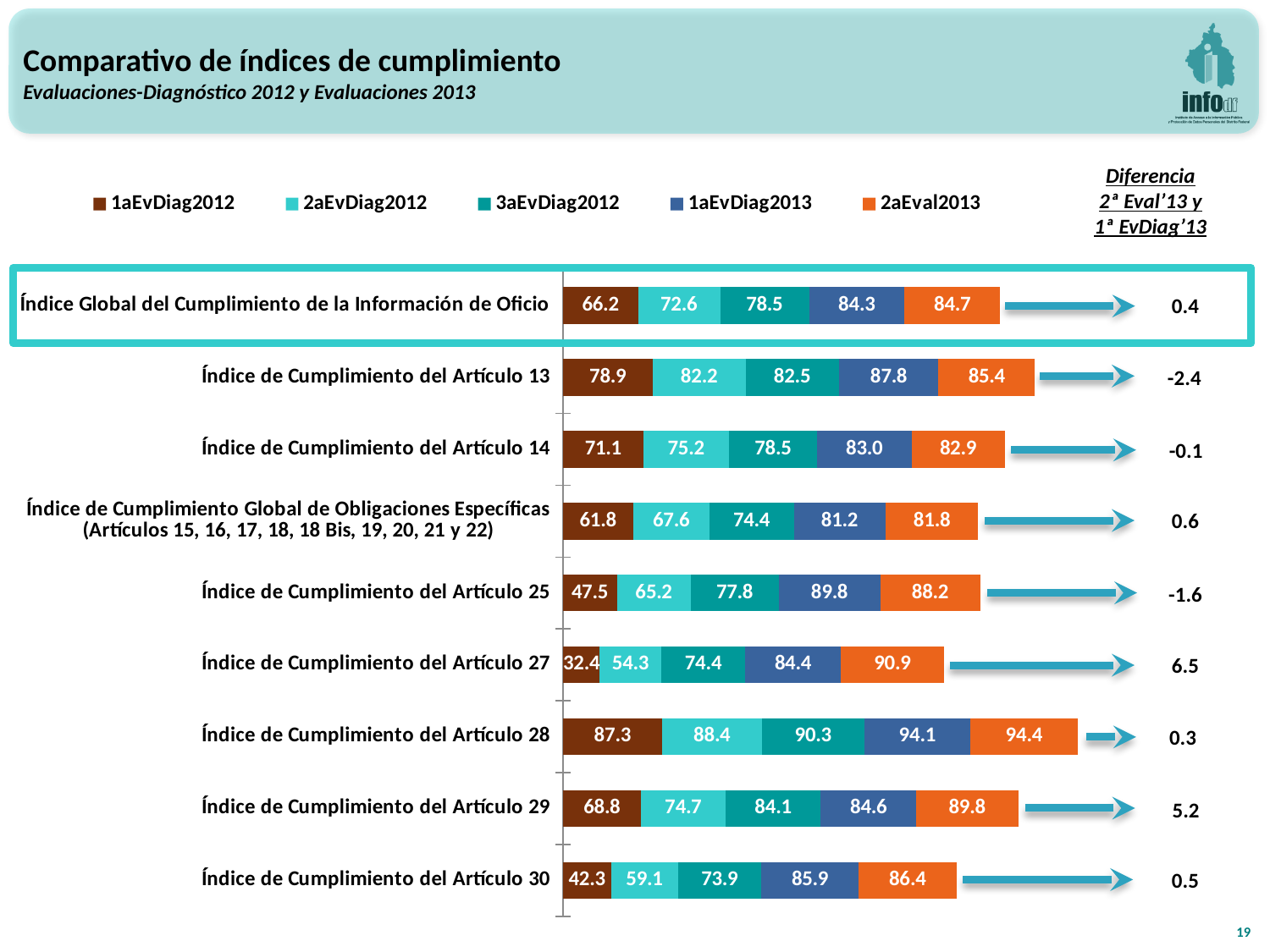
Which category has the highest 2aEval2013 value? Índice de Cumplimiento del Artículo 28 How many series does the legend list? 5 For Índice de Cumplimiento del Artículo 25, which is larger: the 1aEvDiag2013 value or the 2aEval2013 value? 1aEvDiag2013 How many categories (índices) are shown in the chart? 9 What is the difference between the 2aEval2013 and 1aEvDiag2013 values for Índice de Cumplimiento del Artículo 29? 5.2 Which category has the lowest 1aEvDiag2012 value? Índice de Cumplimiento del Artículo 27 What kind of chart is shown on the slide? Stacked bar chart What is the 2aEval2013 value for Índice de Cumplimiento del Artículo 13? 85.4 For Índice de Cumplimiento del Artículo 28, do the values rise or fall from 1aEvDiag2012 to 2aEval2013? Rise What is the Diferencia value shown for Índice de Cumplimiento del Artículo 27? 6.5 What is the 3aEvDiag2012 value for Índice Global del Cumplimiento de la Información de Oficio? 78.5 What is the 1aEvDiag2012 value for Índice de Cumplimiento del Artículo 27? 32.4